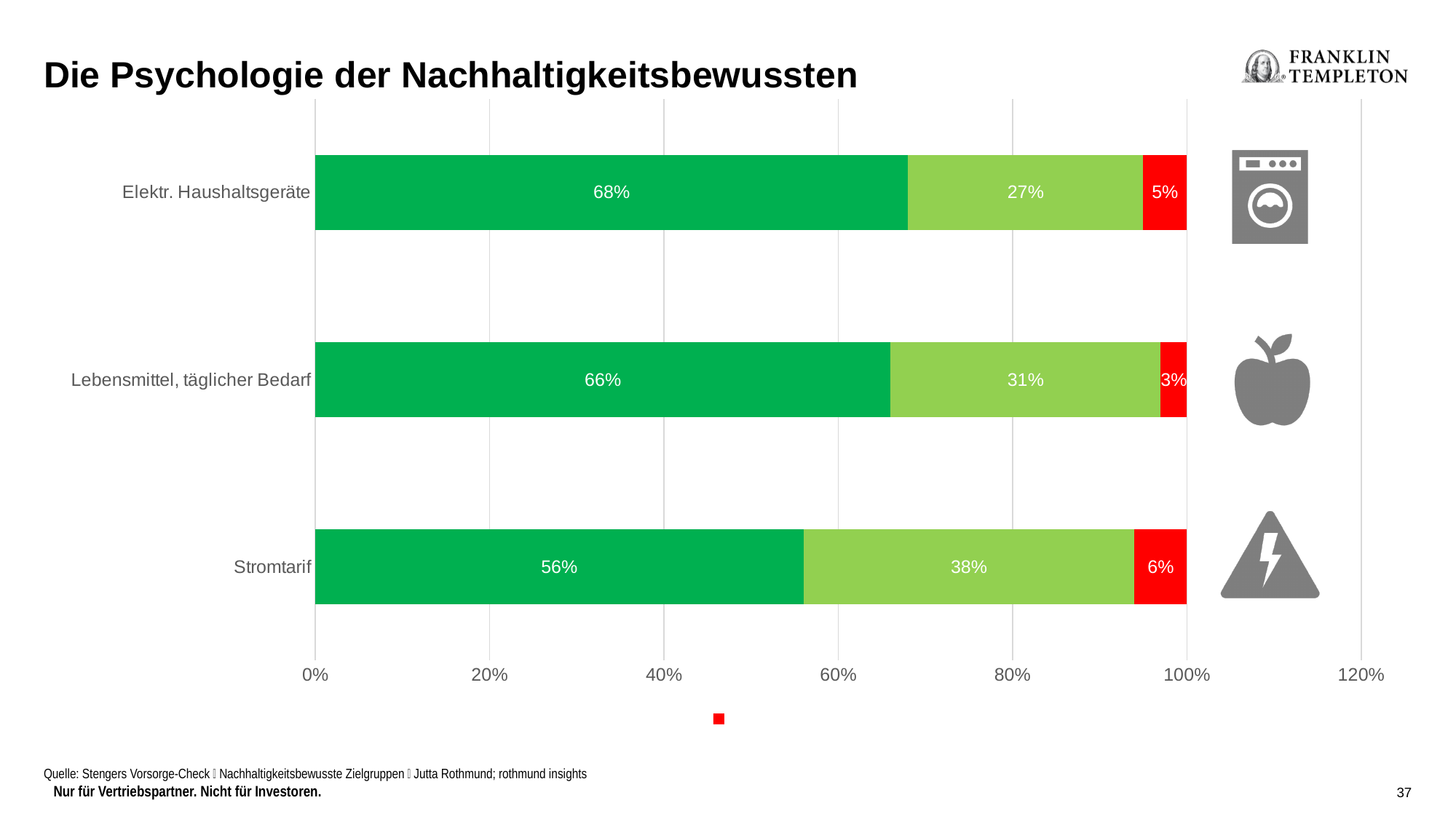
Which category has the largest dark green segment? Elektr. Haushaltsgeräte What is the title of the slide? Die Psychologie der Nachhaltigkeitsbewussten Which category has the smallest red segment? Lebensmittel, täglicher Bedarf Which is larger: the red segment for Stromtarif or the red segment for Elektr. Haushaltsgeräte? Stromtarif What is the difference between the dark green values for Elektr. Haushaltsgeräte and Stromtarif? 12 percentage points What kind of chart is shown on the slide? Stacked bar chart What is the value of the red segment for Elektr. Haushaltsgeräte? 5% How many categories are shown on the chart? 3 What is the value of the dark green segment for Stromtarif? 56% What is the value of the light green segment for Lebensmittel, täglicher Bedarf? 31% Which category has the largest light green segment? Stromtarif What is the total of the three segments for Stromtarif? 100%